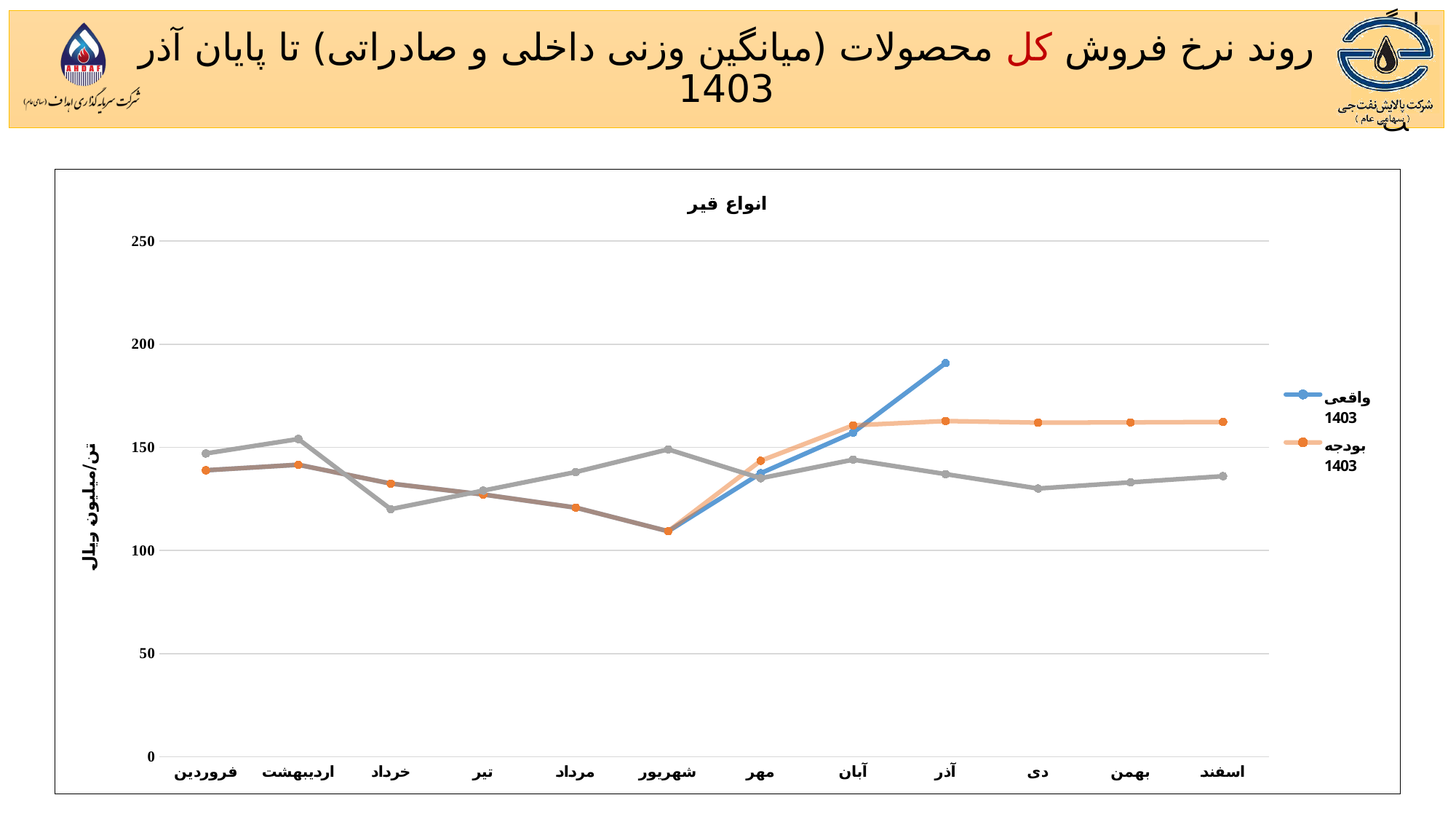
Is the value of بودجه 1403 for اسفند greater or less than 150? greater In آذر, which series has the higher value, واقعی 1403 or بودجه 1403? واقعی 1403 In which month does the بودجه 1403 series reach its lowest value? شهریور Does the واقعی 1403 series rise or fall from شهریور to آذر? rise What kind of chart is shown on the slide? line chart Is the value of واقعی 1403 for آذر greater or less than 200? less How many series does the legend list? 2 Is the value of بودجه 1403 for شهریور greater or less than 150? less How many months are shown on the x axis? 12 Which two series are listed in the legend? واقعی 1403 and بودجه 1403 What is the title of the chart? انواع قیر